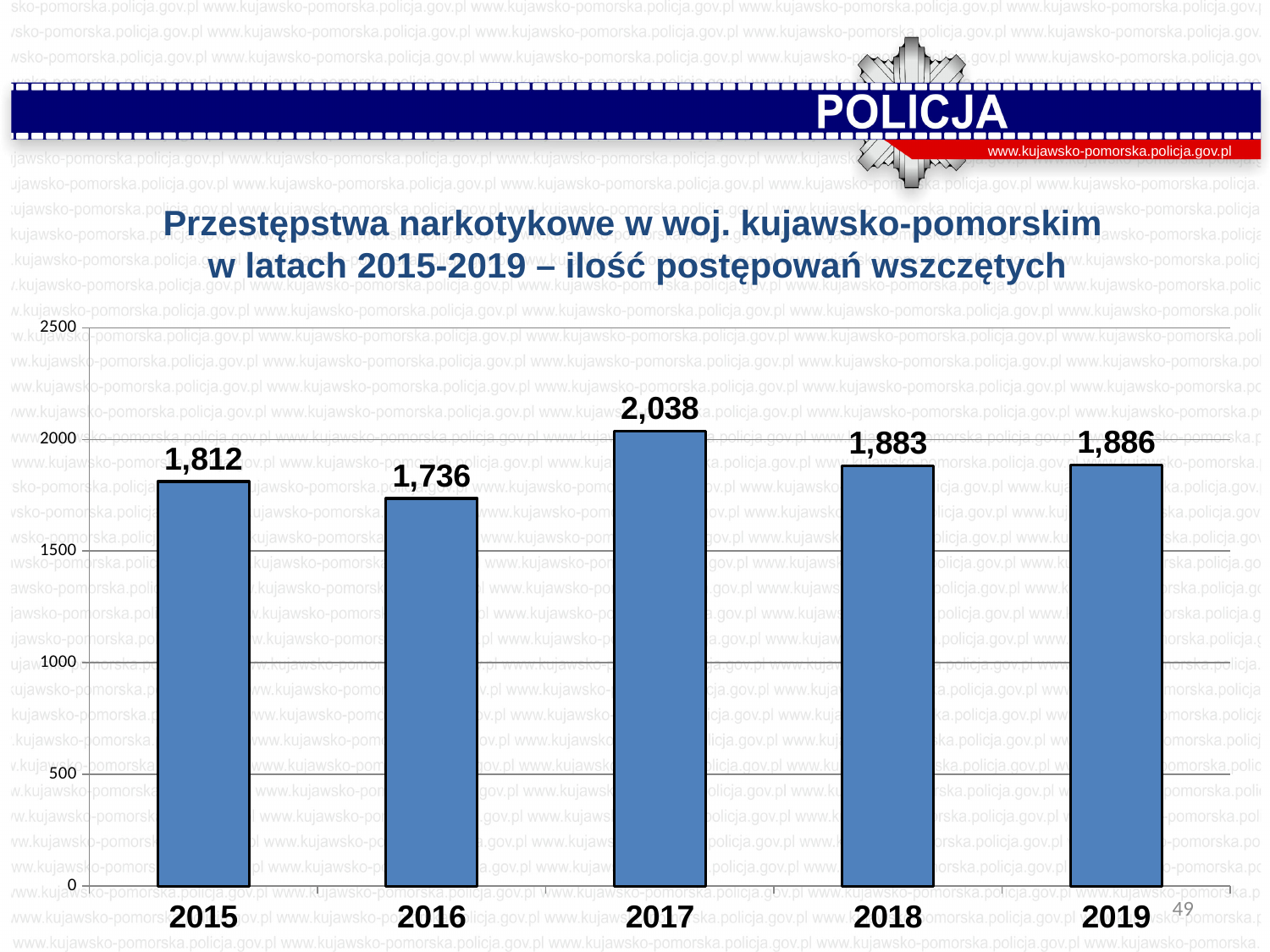
What is the value shown for 2015? 1,812 Which year has the lowest value? 2016 Is the value for 2017 greater or less than 2000? greater What type of chart is shown on the slide? bar chart Which is larger, the value for 2015 or the value for 2018? 2018 Which year has the highest value? 2017 What is the difference between the values for 2017 and 2016? 302 What is the value shown for 2019? 1,886 Did the value rise or fall from 2015 to 2016? fall What is the value shown for 2017? 2,038 How many years (categories) are plotted in the chart? 5 What is the difference between the values for 2015 and 2016? 76